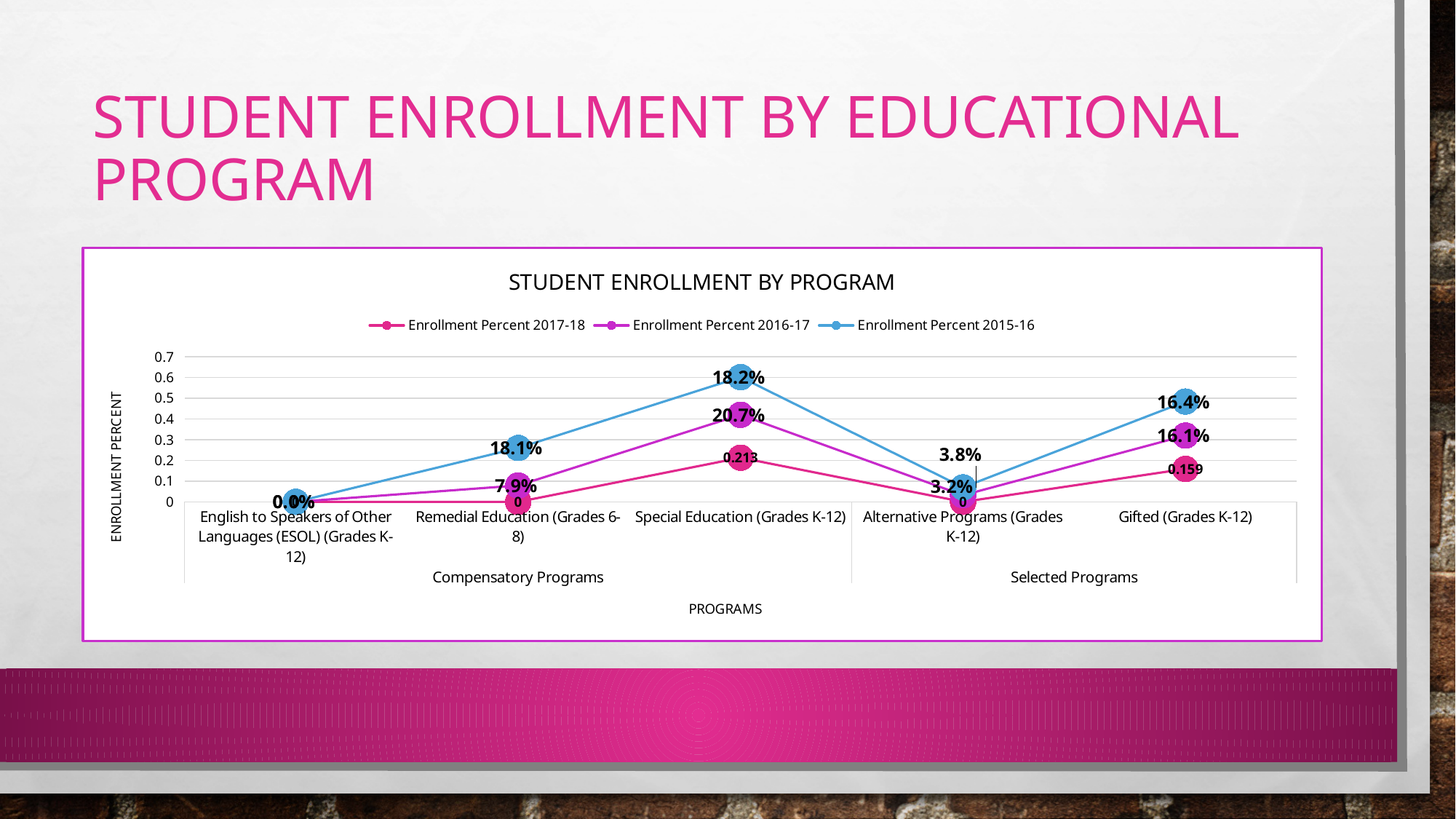
Which program has the highest point for Enrollment Percent 2015-16? Special Education (Grades K-12) What kind of chart is shown on the slide? Line chart What is the data label for Enrollment Percent 2015-16 at Gifted (Grades K-12)? 16.4% How many program categories are plotted along the x axis? 5 At Gifted (Grades K-12), which series plots higher: Enrollment Percent 2015-16 or Enrollment Percent 2016-17? Enrollment Percent 2015-16 Is the Enrollment Percent 2015-16 point for Special Education (Grades K-12) greater or less than 0.5 on the axis? greater What is the difference between the Enrollment Percent 2017-18 labels for Special Education (Grades K-12) and Gifted (Grades K-12)? 0.054 What is the data label for Enrollment Percent 2016-17 at Special Education (Grades K-12)? 20.7% How many series does the legend list? 3 What is the data label for Enrollment Percent 2017-18 at Special Education (Grades K-12)? 0.213 What is the data label for Enrollment Percent 2017-18 at Gifted (Grades K-12)? 0.159 What is the title of the chart? STUDENT ENROLLMENT BY PROGRAM